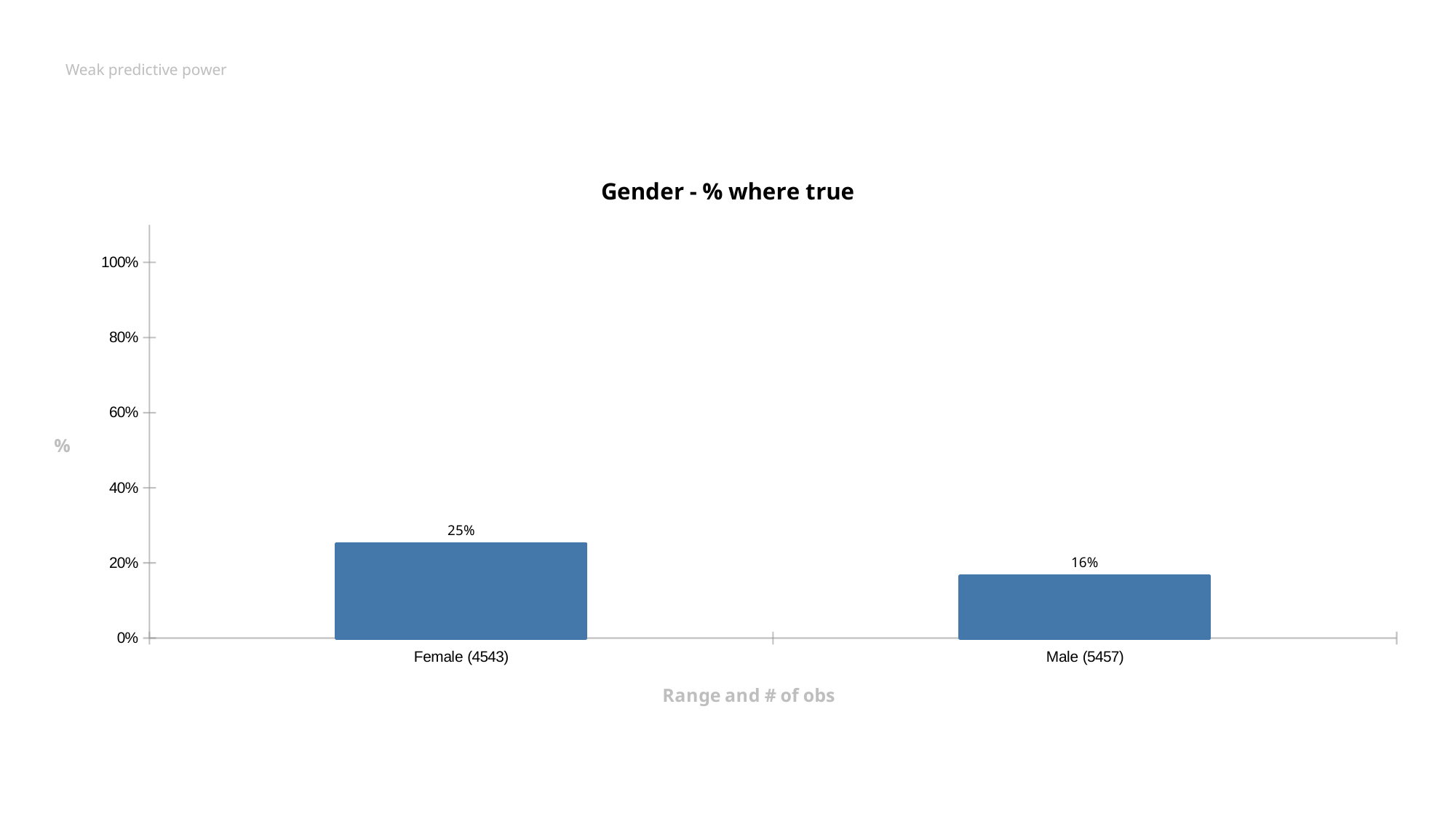
Which category has the highest value? Female (4543) Is the value for Female (4543) greater or less than 20%? greater How many categories are shown on the x axis? 2 What is the x-axis title of the chart? Range and # of obs What is the difference between the values for Female (4543) and Male (5457)? 9% What is the value for Female (4543)? 25% Is the value for Male (5457) greater or less than 20%? less Which is larger, the value for Female (4543) or the value for Male (5457)? Female (4543) Which category has the lowest value? Male (5457) What is the title of the chart? Gender - % where true What is the value for Male (5457)? 16% What kind of chart is shown on the slide? bar chart